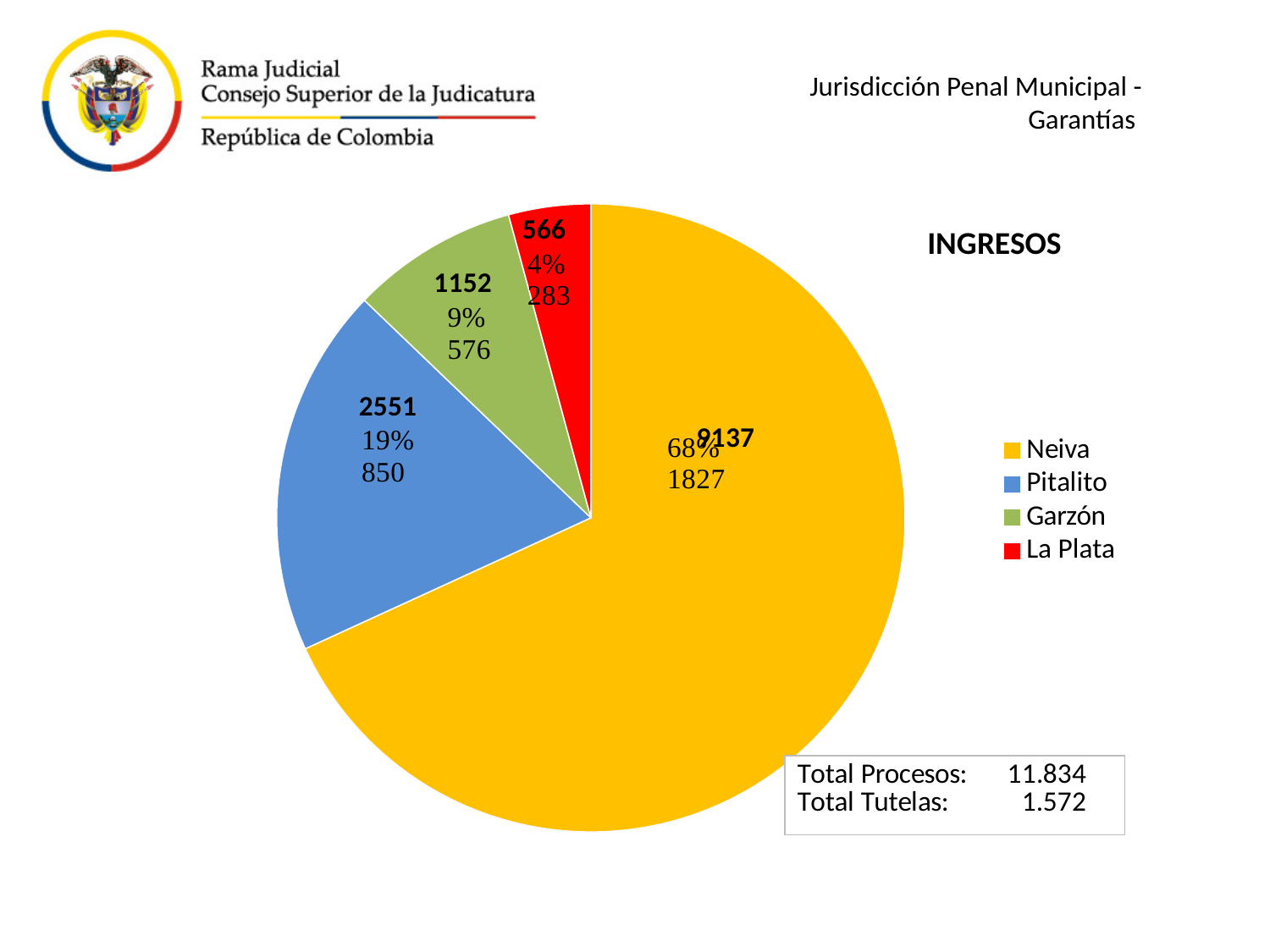
How many entries does the legend list? 4 What is the value labelled on the Pitalito slice? 2551 What percentage share of the pie does Pitalito have? 19% What is the value labelled on the Neiva slice? 9137 What is the value labelled on the Garzón slice? 1152 How many slices does the pie chart have? 4 What is the title of the chart? INGRESOS What kind of chart is shown on the slide? pie chart Which category has the smallest slice of the pie? La Plata What is the difference between the Pitalito value and the Garzón value? 1399 Which category has the largest slice of the pie? Neiva What is the value labelled on the La Plata slice? 566